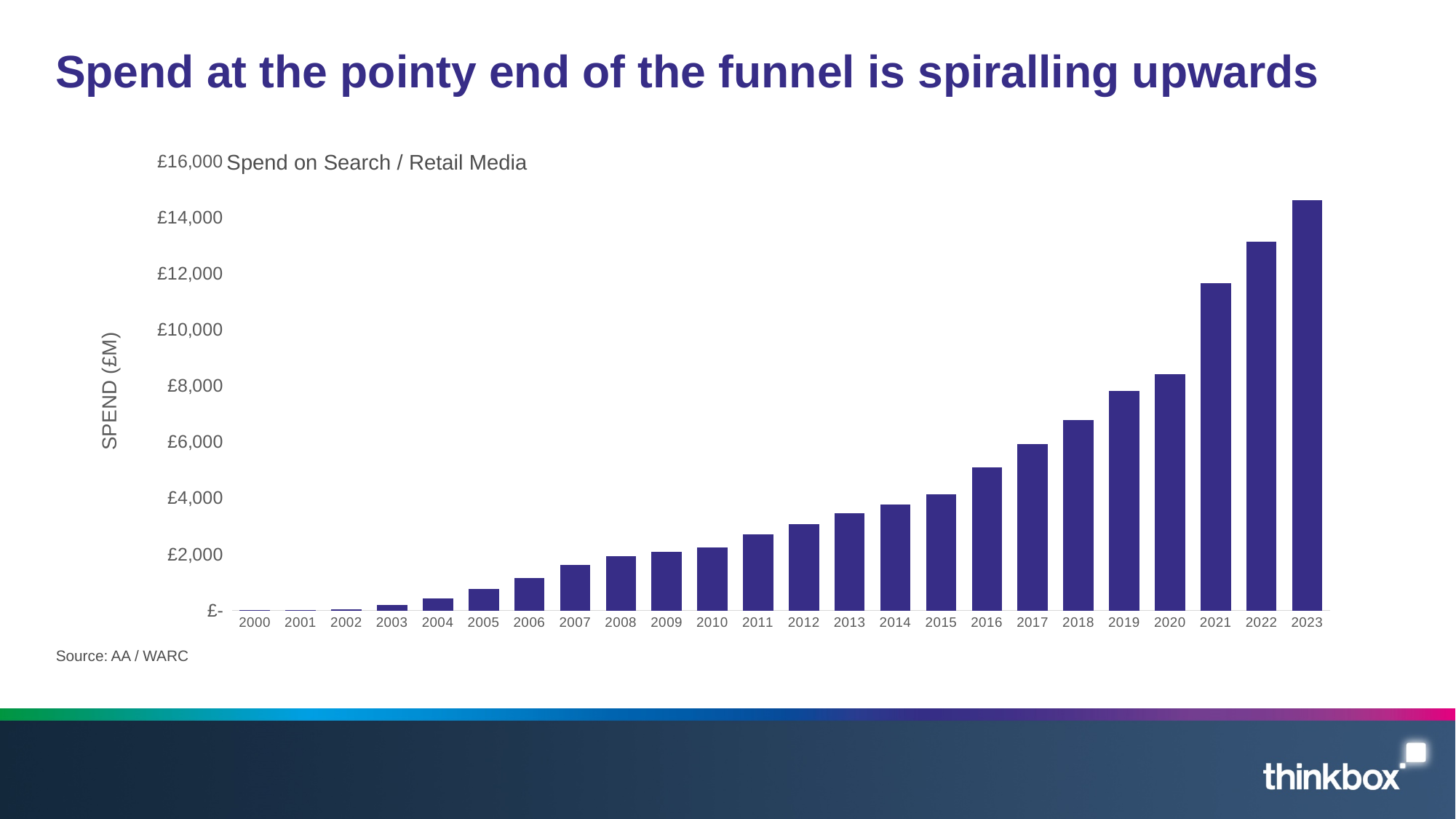
Is the value for 2021 greater or less than £10,000? greater Is the value for 2018 greater or less than £6,000? greater Is the value for 2023 greater or less than £14,000? greater What kind of chart is shown on the slide? bar chart How many years are shown along the x axis of the chart? 24 What is the title of the chart? Spend on Search / Retail Media What is the label on the vertical axis of the chart? SPEND (£M) Which year has the larger spend, 2010 or 2016? 2016 Do the values generally rise or fall from 2000 to 2023? rise Which year has the highest spend in the chart? 2023